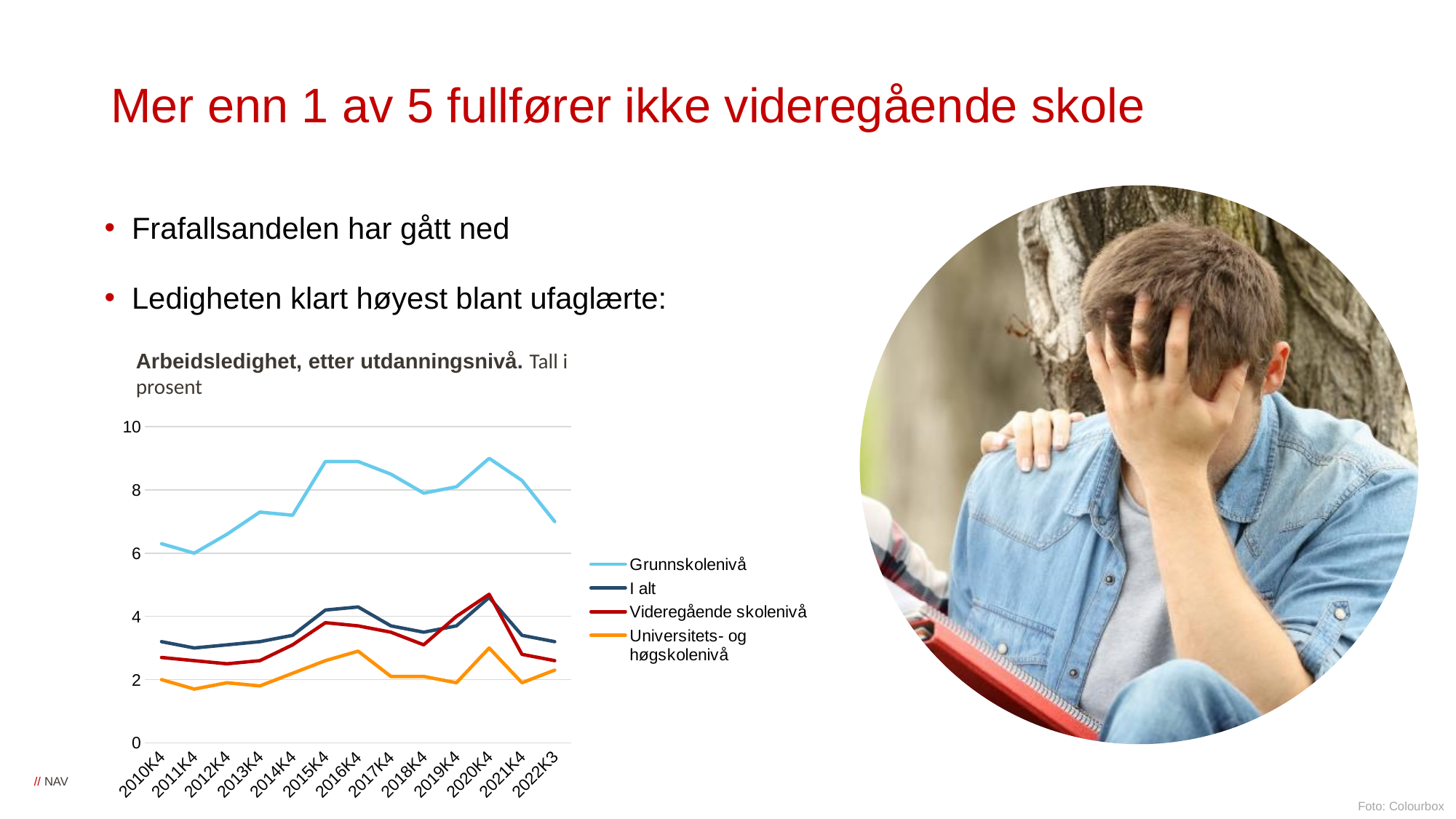
What kind of chart is shown on the slide? line chart In 2020K4, which is larger: the value for Grunnskolenivå or the value for Universitets- og høgskolenivå? Grunnskolenivå Is the value for Grunnskolenivå in 2020K4 greater or less than 8? greater Does the Grunnskolenivå line rise or fall from 2020K4 to 2022K3? fall What is the title of the chart? Arbeidsledighet, etter utdanningsnivå. Tall i prosent Is the value for Videregående skolenivå in 2020K4 greater or less than 4? greater Which series has the highest values throughout the chart? Grunnskolenivå How many time points are shown on the x axis of the chart? 13 Which series has the lowest values throughout the chart? Universitets- og høgskolenivå Is the value for Universitets- og høgskolenivå in 2016K4 greater or less than 4? less Does the Grunnskolenivå line rise or fall from 2011K4 to 2015K4? rise How many series does the legend of the chart list? 4